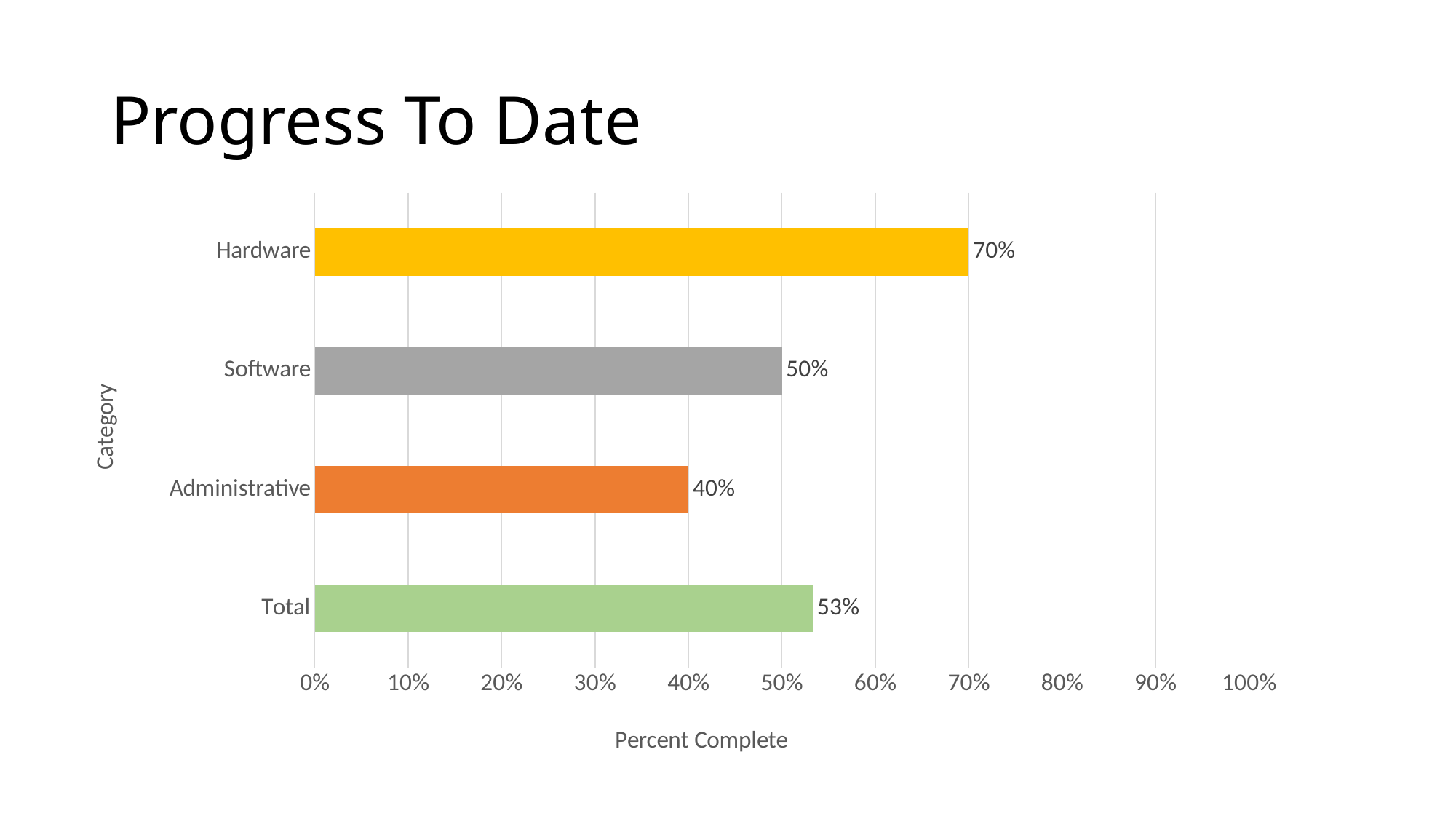
What is the difference in percent complete between Hardware and Administrative? 30% What is the percent complete for Hardware? 70% What is the percent complete for Total? 53% What kind of chart is shown on the slide? Bar chart What is the percent complete for Software? 50% Which category has the highest percent complete? Hardware Which has a higher percent complete, Software or Administrative? Software How many categories are shown on the chart? 4 What is the difference in percent complete between Total and Software? 3% Which category has the lowest percent complete? Administrative What is the percent complete for Administrative? 40% What is the label of the horizontal axis? Percent Complete